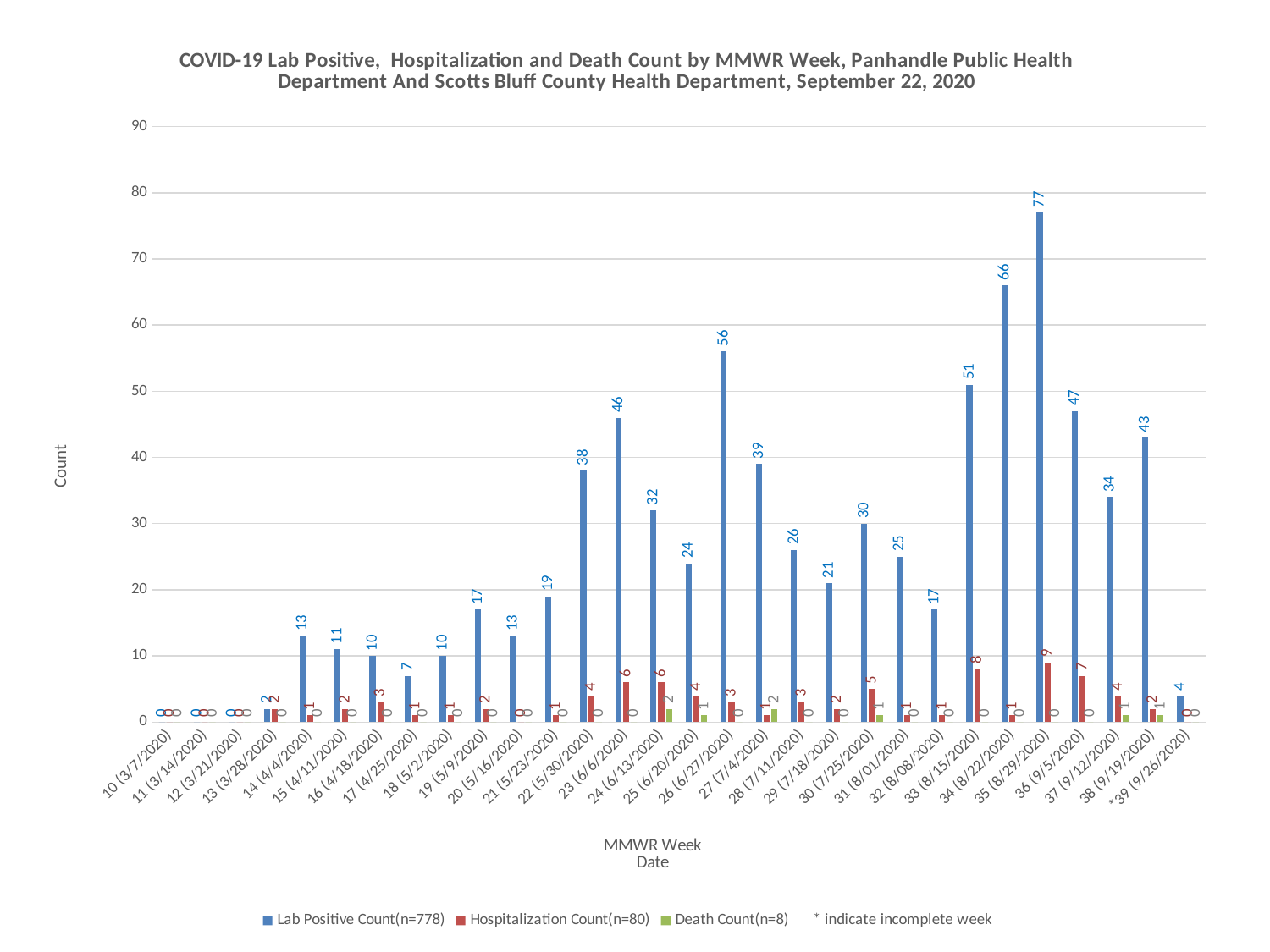
Which MMWR week has the highest Lab Positive Count? 35 (8/29/2020) What kind of chart is shown on the slide? Bar chart How many series does the legend list? 3 How many MMWR weeks are shown on the x axis? 30 What is the Hospitalization Count for MMWR week 33 (8/15/2020)? 8 What is the Hospitalization Count for MMWR week 35 (8/29/2020)? 9 Which has a higher Lab Positive Count, week 23 (6/6/2020) or week 27 (7/4/2020)? 23 (6/6/2020) Is the Lab Positive Count for week 22 (5/30/2020) greater or less than 30? greater What is the Lab Positive Count for MMWR week 26 (6/27/2020)? 56 What is the Death Count for MMWR week 24 (6/13/2020)? 2 What total n is given for the Lab Positive Count series in the legend? n=778 What is the difference between the Lab Positive Count for week 35 (8/29/2020) and week 34 (8/22/2020)? 11